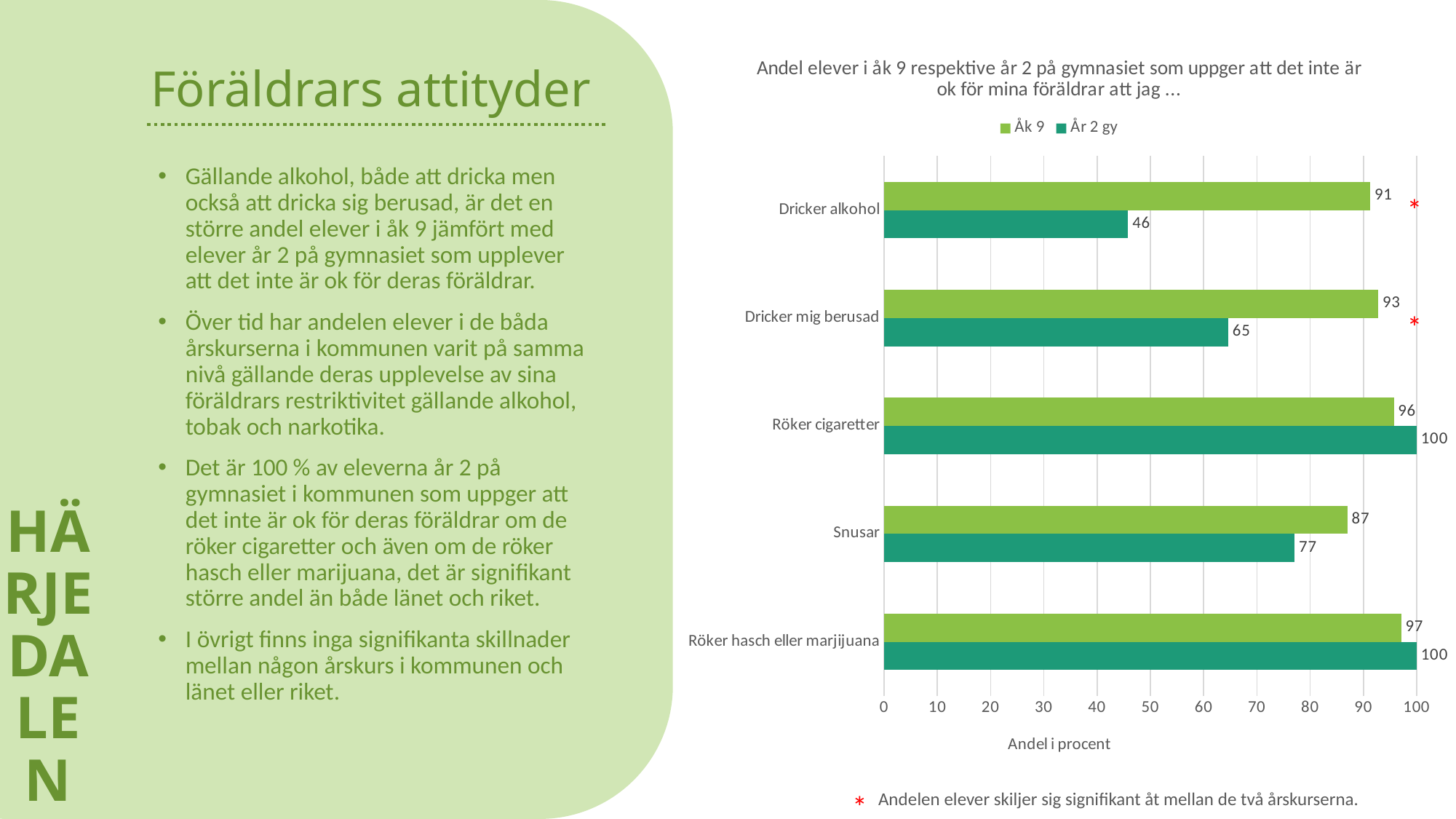
What is the label of the horizontal axis? Andel i procent What kind of chart is shown on the slide? Bar chart What is the value for År 2 gy in the Snusar category? 77 What is the difference between the Åk 9 and År 2 gy values for Dricker alkohol? 45 How many categories are shown on the chart? 5 What is the value for Åk 9 in the Dricker alkohol category? 91 Which category has the highest value for Åk 9? Röker hasch eller marjijuana What is the difference between the Åk 9 and År 2 gy values for Snusar? 10 Which category has the lowest value for År 2 gy? Dricker alkohol Which is larger for Röker cigaretter: the Åk 9 value or the År 2 gy value? År 2 gy What is the value for År 2 gy in the Dricker mig berusad category? 65 How many series does the legend list? 2